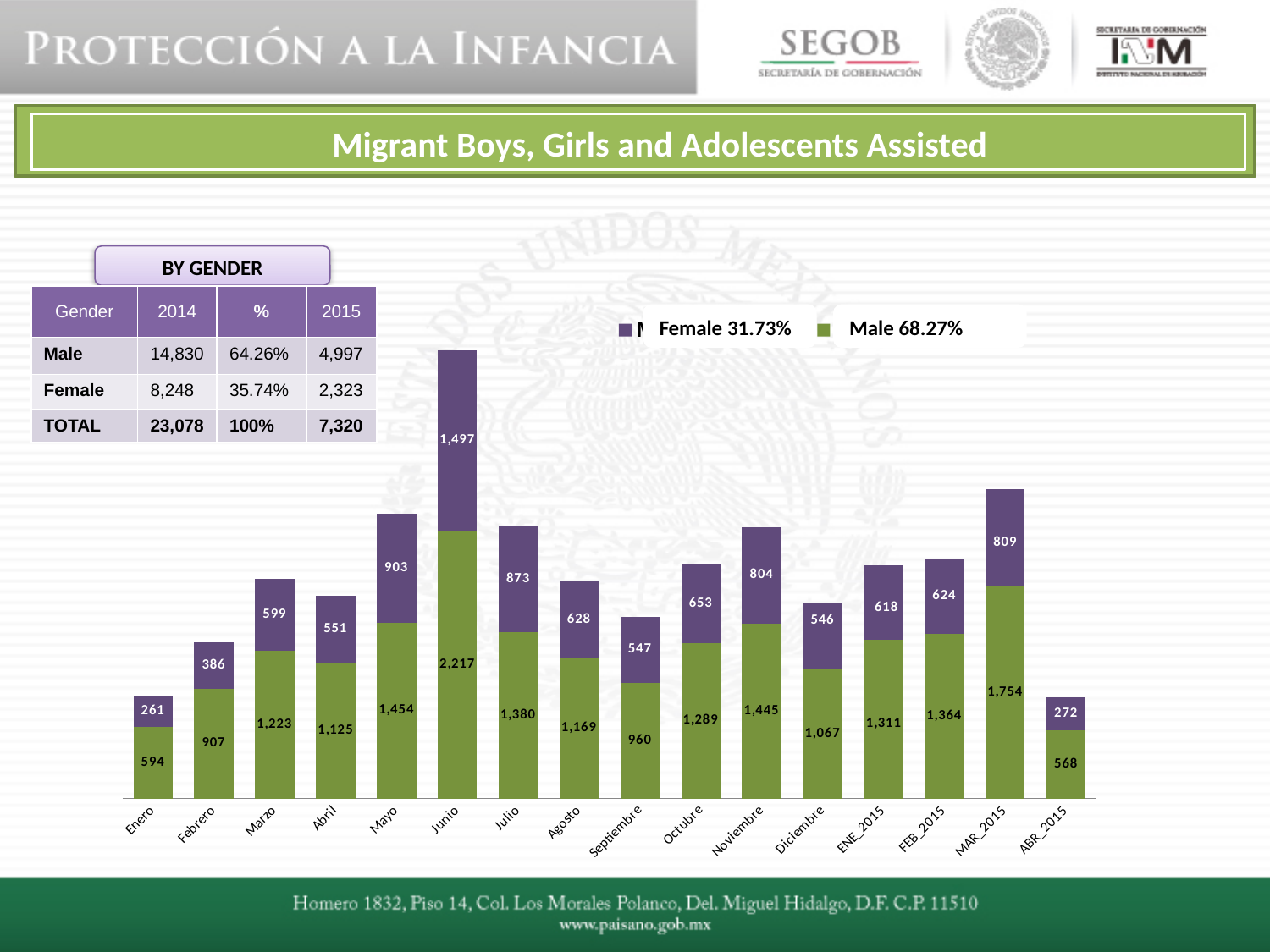
How many months are shown on the x axis? 16 What is the total of the stacked bar for Enero? 855 Which month has the highest Male value? Junio What is the difference between the Male values for Junio and Mayo? 763 Which month has the highest Female value? Junio What is the Male value for Septiembre? 960 What is the Female value for MAR_2015? 809 How many series does the legend list? 2 What kind of chart is shown? Stacked bar chart What is the Male value for Junio? 2,217 Which month has the lowest Male value? ABR_2015 Which is larger, the Female value for Noviembre or the Female value for Octubre? Noviembre